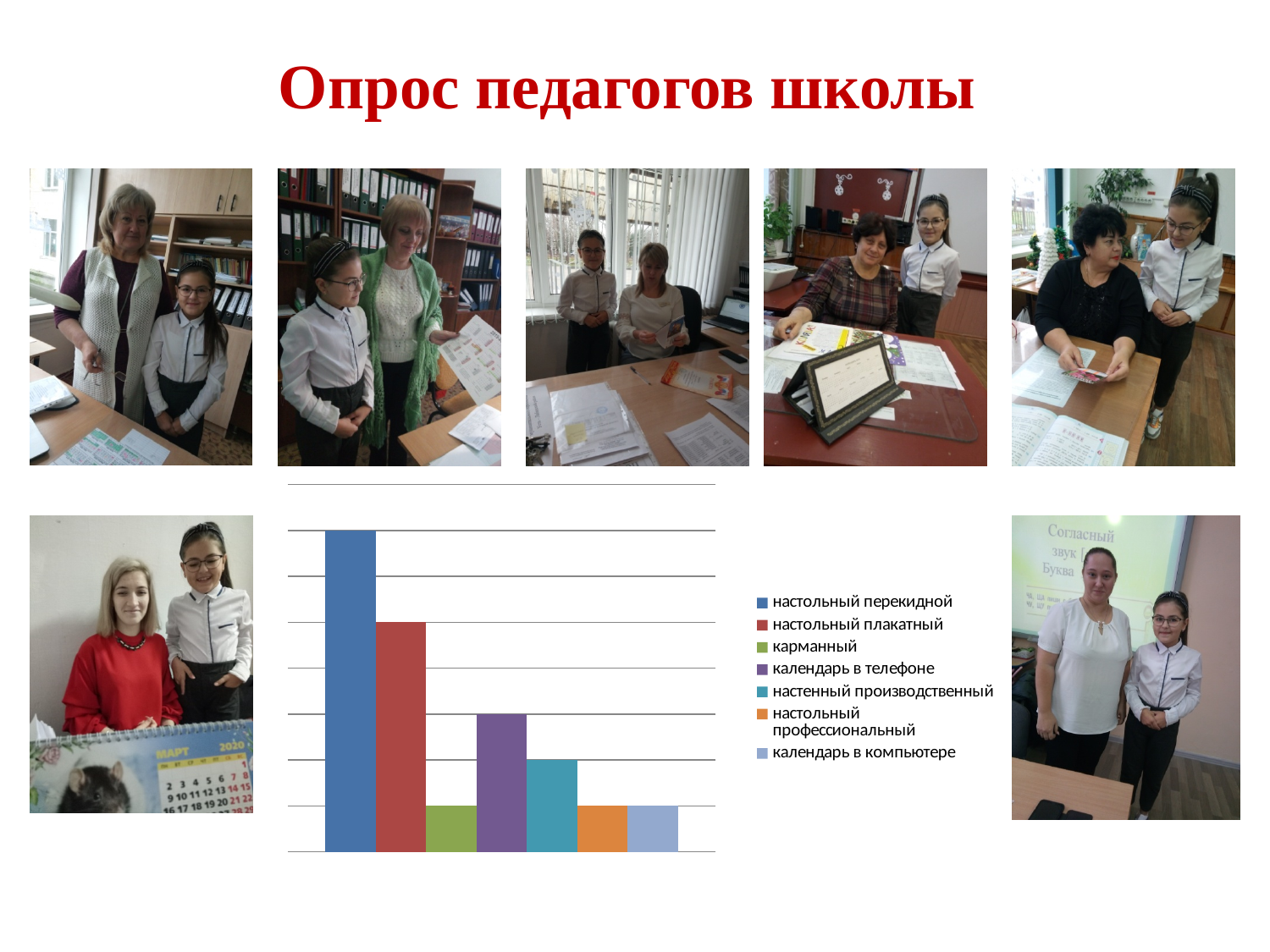
Which category has the highest bar in the chart? настольный перекидной Which category has the second highest bar in the chart? настольный плакатный Which is larger in the chart: календарь в телефоне or настенный производственный? календарь в телефоне Which is larger in the chart: настольный перекидной or настольный плакатный? настольный перекидной Which legend entry is shown in red in the chart? настольный плакатный How many entries does the chart legend list? 7 How many bars are plotted in the chart? 7 Which is larger in the chart: настольный плакатный or календарь в телефоне? настольный плакатный What colour is the bar for настольный перекидной in the chart? blue What kind of chart is shown on the slide? bar chart